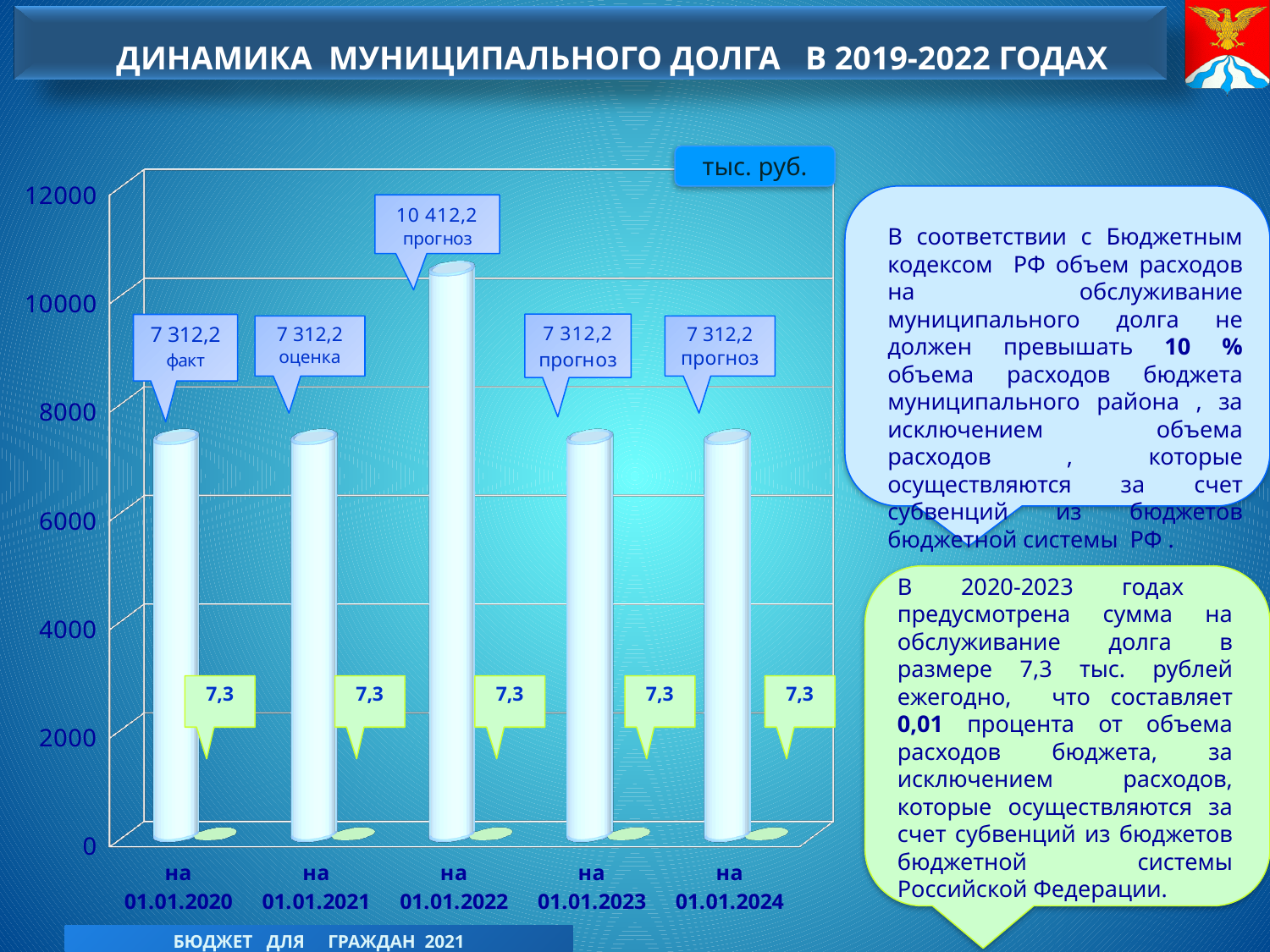
What is the municipal debt value shown for на 01.01.2022? 10 412,2 How many dates (categories) are shown on the x axis of the chart? 5 What label is attached to the value 7 312,2 for на 01.01.2020? факт What unit of measurement is indicated for the chart? тыс. руб. Which date has the highest municipal debt value on the chart? на 01.01.2022 What is the difference between the municipal debt value for на 01.01.2022 and the value for на 01.01.2021? 3 100 Is the municipal debt value for на 01.01.2022 greater or less than 10000? greater What kind of chart is shown on the slide? bar chart Is the municipal debt value for на 01.01.2023 greater or less than 8000? less What is the municipal debt value shown for на 01.01.2024? 7 312,2 What value is shown in the green label for debt servicing at each date? 7,3 What is the municipal debt value shown for на 01.01.2020? 7 312,2